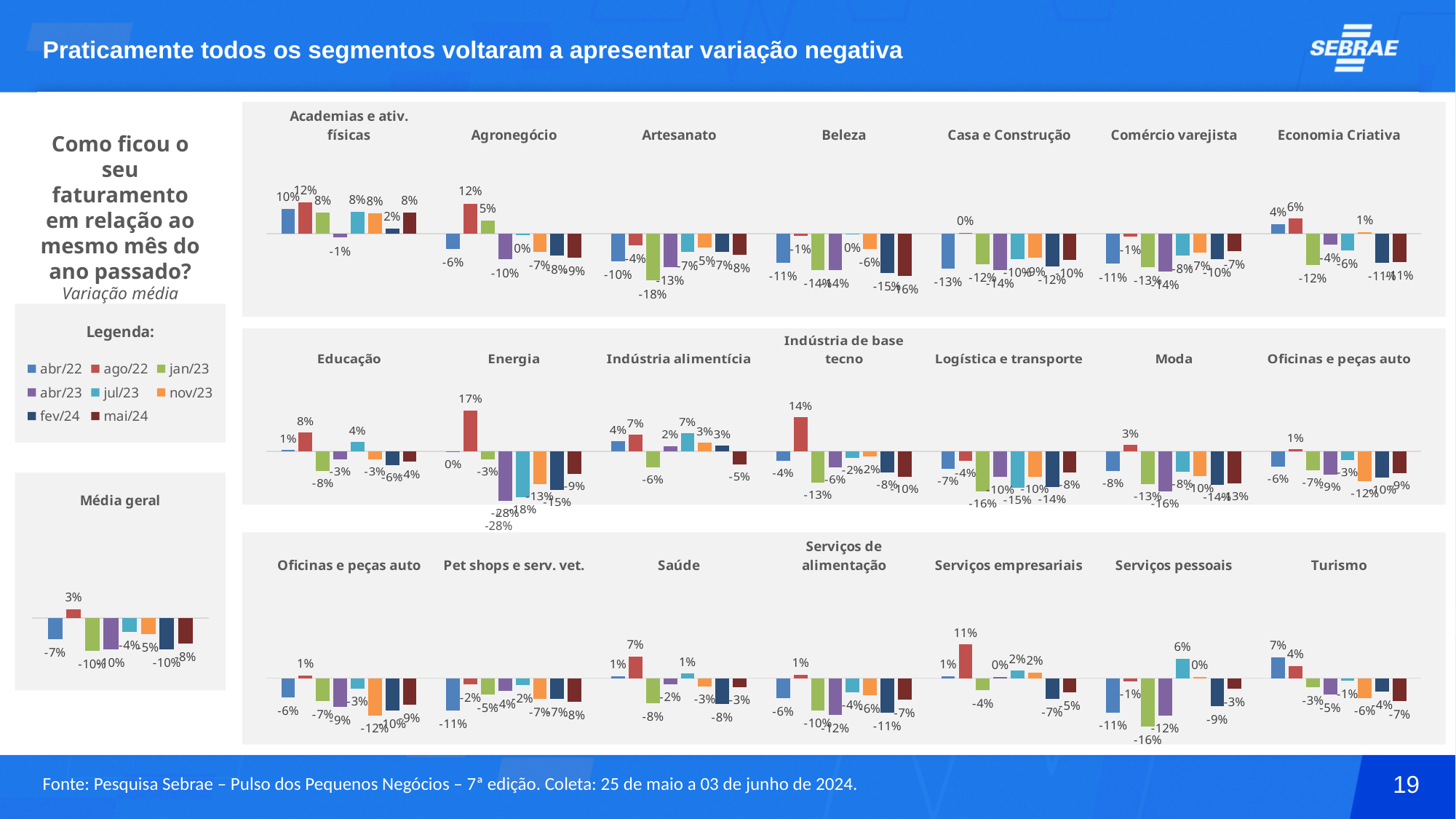
In the Agronegócio chart, what is the value for jan/23? 5% In the Indústria de base tecno chart, what is the value for ago/22? 14% In the Academias e ativ. físicas chart, which is larger, the ago/22 value or the abr/23 value? ago/22 In the Média geral chart, what is the value for ago/22? 3% In the Energia chart, what is the value for ago/22? 17% In the Turismo chart, what is the value for abr/22? 7% What kind of chart is the Média geral chart? bar chart How many series does the legend list? 8 In the Média geral chart, what is the value for mai/24? -8% In the Energia chart, which period has the highest value? ago/22 In the Serviços empresariais chart, what is the difference between the ago/22 value and the fev/24 value? 18 percentage points In the Serviços pessoais chart, what is the value for jul/23? 6%